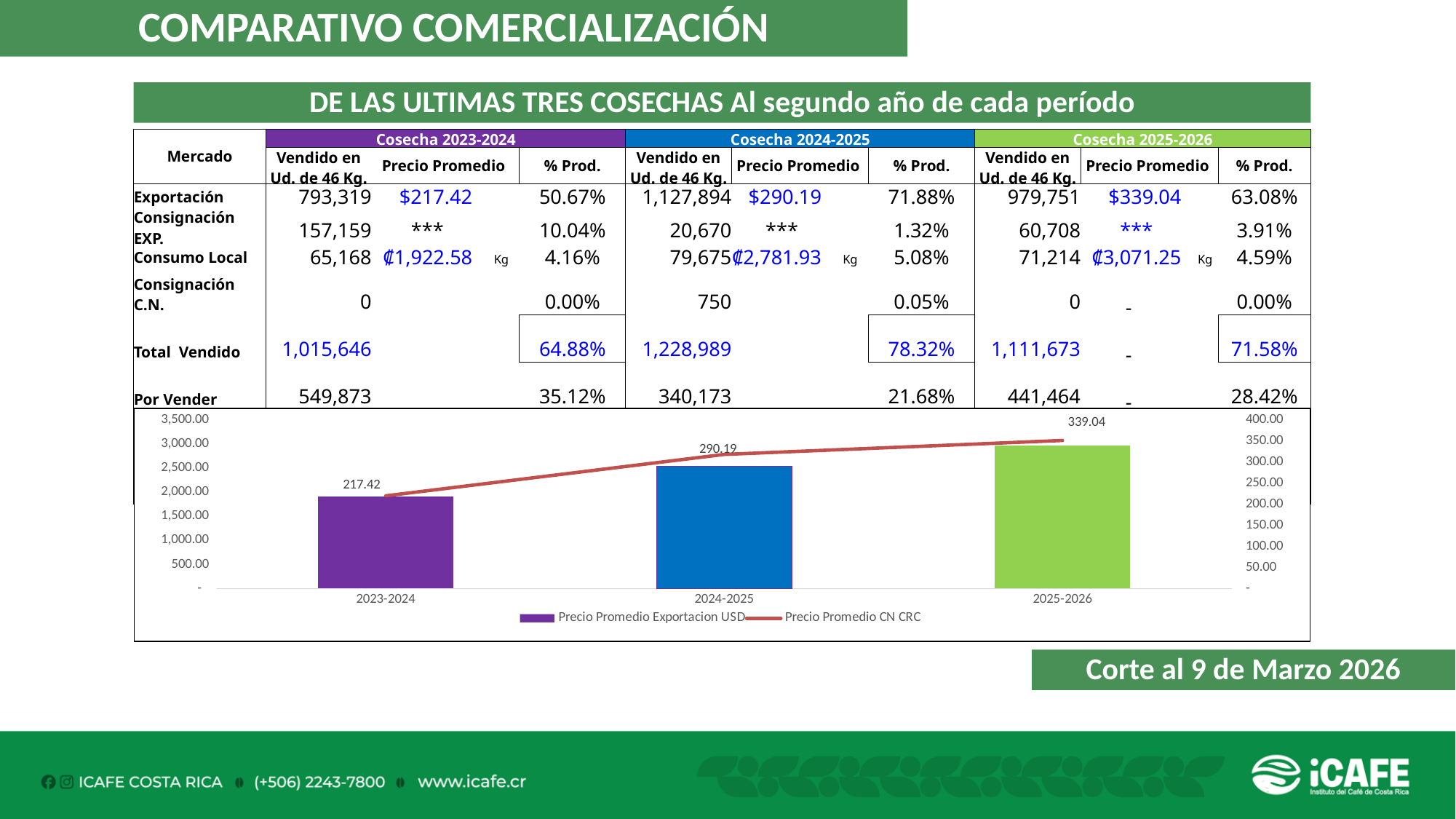
How many series does the chart legend list? 2 What is the value of the Precio Promedio Exportacion USD bar for 2023-2024? 217.42 Is the Precio Promedio CN CRC line value for 2024-2025 greater or less than 2,500.00 on the left axis? greater Which is larger, the Precio Promedio Exportacion USD bar for 2024-2025 or for 2023-2024? 2024-2025 Do the Precio Promedio Exportacion USD bars rise or fall from 2023-2024 to 2025-2026? rise What is the value of the Precio Promedio Exportacion USD bar for 2025-2026? 339.04 Which harvest period has the highest Precio Promedio Exportacion USD bar? 2025-2026 Is the Precio Promedio CN CRC line value for 2023-2024 greater or less than 1,500.00 on the left axis? greater How many harvest periods are shown on the x axis of the chart? 3 What is the value of the Precio Promedio Exportacion USD bar for 2024-2025? 290.19 What is the difference between the Precio Promedio Exportacion USD values for 2025-2026 and 2023-2024? 121.62 Which harvest period has the lowest Precio Promedio Exportacion USD bar? 2023-2024